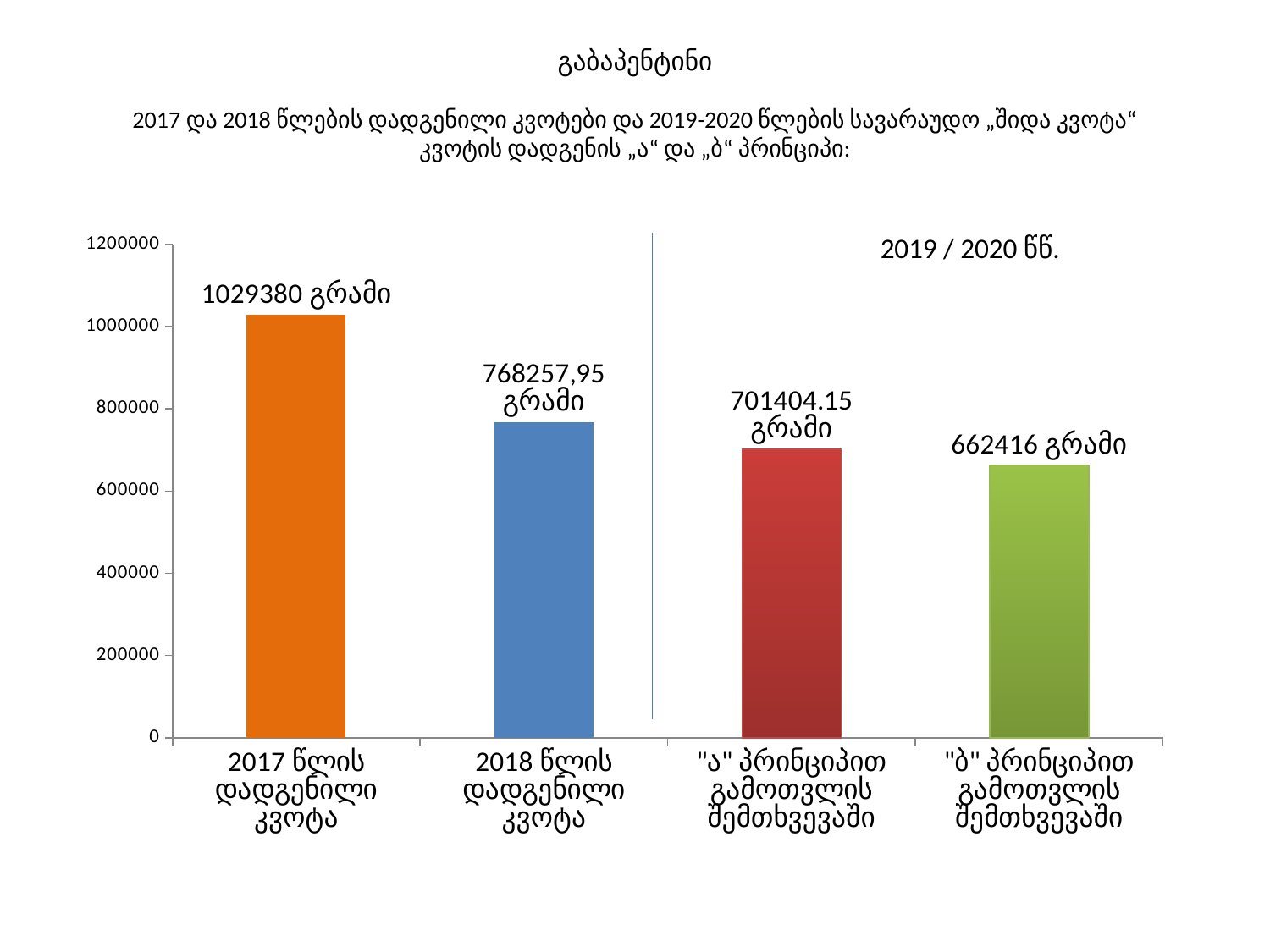
What is the value shown for the 2017 წლის დადგენილი კვოტა bar? 1029380 გრამი What type of chart is shown on the slide? Bar chart Which category has the lowest value in the chart? "ბ" პრინციპით გამოთვლის შემთხვევაში Which category has the highest value in the chart? 2017 წლის დადგენილი კვოტა What value is labelled on the "ბ" პრინციპით გამოთვლის შემთხვევაში bar? 662416 გრამი What is the difference between the "ა" principle value (701404.15) and the "ბ" principle value (662416)? 38988.15 Do the bar values rise or fall from left to right across the chart? Fall How many bars (categories) are plotted in the chart? 4 What is the value shown for the 2018 წლის დადგენილი კვოტა bar? 768257,95 გრამი What value is labelled on the "ა" პრინციპით გამოთვლის შემთხვევაში bar? 701404.15 გრამი What is the difference between the 2017 quota (1029380) and the 2018 quota (768257,95)? 261122,05 Which is larger: the 2018 წლის დადგენილი კვოტა or the "ა" პრინციპით value? 2018 წლის დადგენილი კვოტა